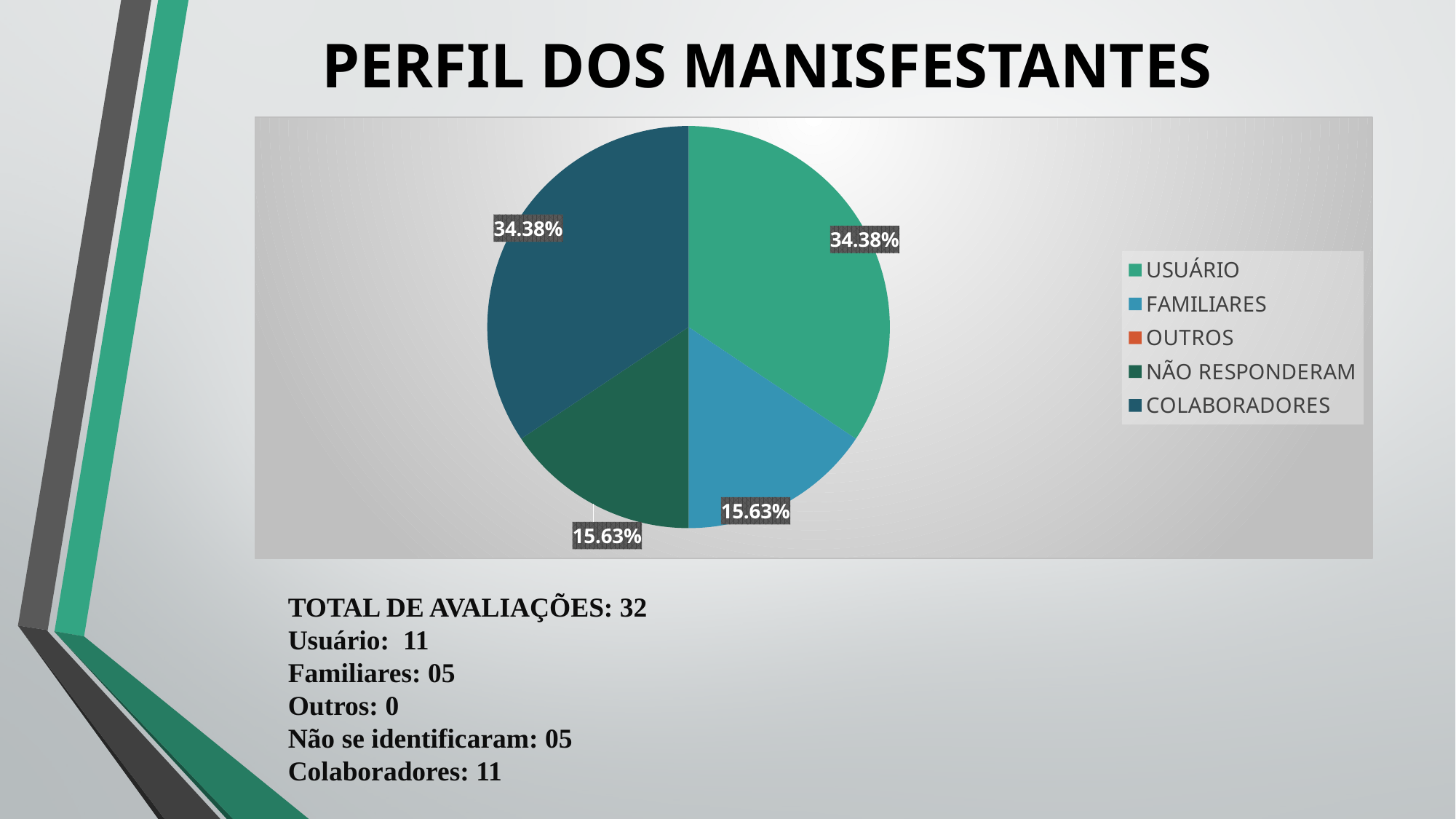
Which is larger, the NÃO RESPONDERAM slice or the COLABORADORES slice? COLABORADORES Which legend entry has no visible slice in the pie? OUTROS What kind of chart is shown on the slide? pie chart What share of the pie does FAMILIARES represent? 15.63% How many entries does the legend list? 5 Which is larger, the USUÁRIO slice or the FAMILIARES slice? USUÁRIO What is the chart's title? PERFIL DOS MANISFESTANTES What share of the pie does NÃO RESPONDERAM represent? 15.63% What share of the pie does COLABORADORES represent? 34.38% What is the difference between the USUÁRIO share and the FAMILIARES share? 18.75% How many slices are visible in the pie? 4